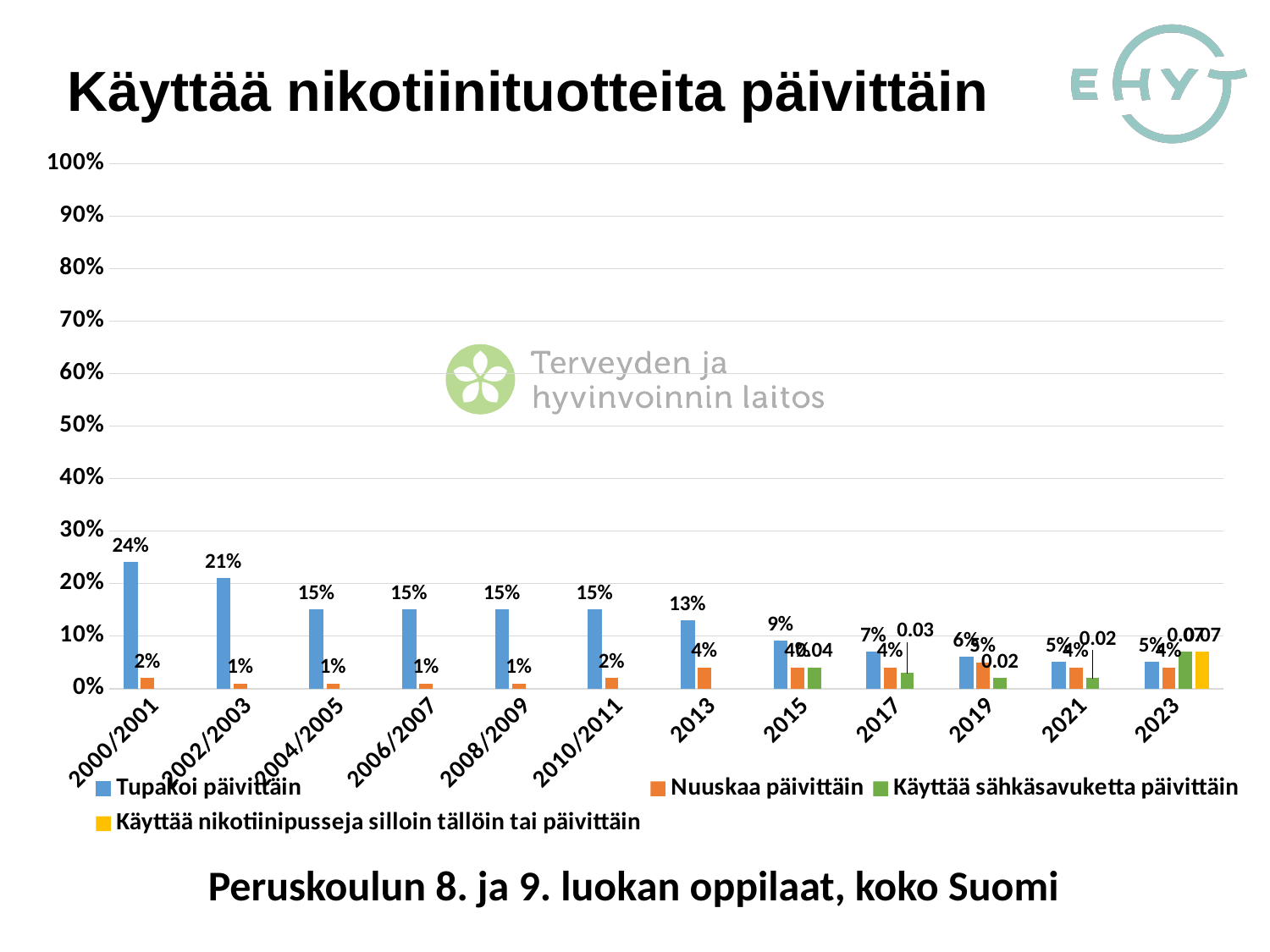
What is the value for Tupakoi päivittäin in 2000/2001? 24% Is the value for Tupakoi päivittäin in 2000/2001 greater or less than 20%? greater In which year is Tupakoi päivittäin highest? 2000/2001 What is the value for Tupakoi päivittäin in 2013? 13% Which is larger for Tupakoi päivittäin: 2002/2003 or 2004/2005? 2002/2003 What is the difference between Tupakoi päivittäin in 2000/2001 and in 2002/2003? 3 percentage points What kind of chart is shown on the slide? bar chart Does Tupakoi päivittäin rise or fall from 2000/2001 to 2023? fall How many year categories are shown on the x axis? 12 What is the value for Nuuskaa päivittäin in 2013? 4% How many series does the legend list? 4 What is the value for Käyttää sähkäsavuketta päivittäin in 2017? 0.03